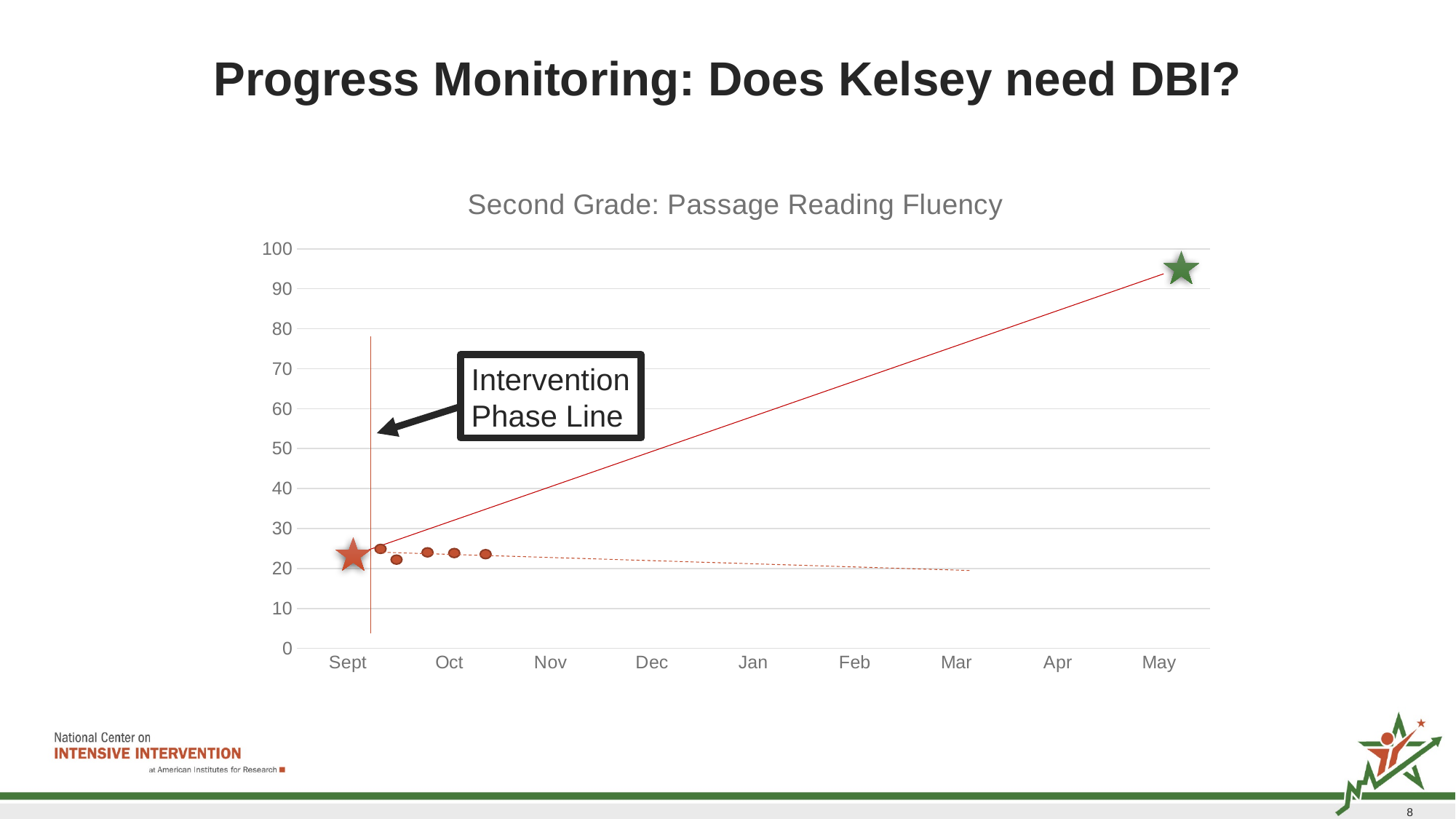
Is the value of the red star in Sept greater or less than 30? less What is the title of the chart? Second Grade: Passage Reading Fluency Which month is the last label on the x axis? May Does the solid red goal line rise or fall from Sept to May? rise Is the value of the green star in May greater or less than 90? greater What kind of chart is shown on the slide? line chart Does the dashed trend line through the red data points rise or fall along the x axis? fall How many month labels are shown on the x axis? 9 What is the highest value shown on the y axis? 100 Are the red progress-monitoring data points greater or less than 40? less How many red circular data points are plotted after the intervention phase line? 5